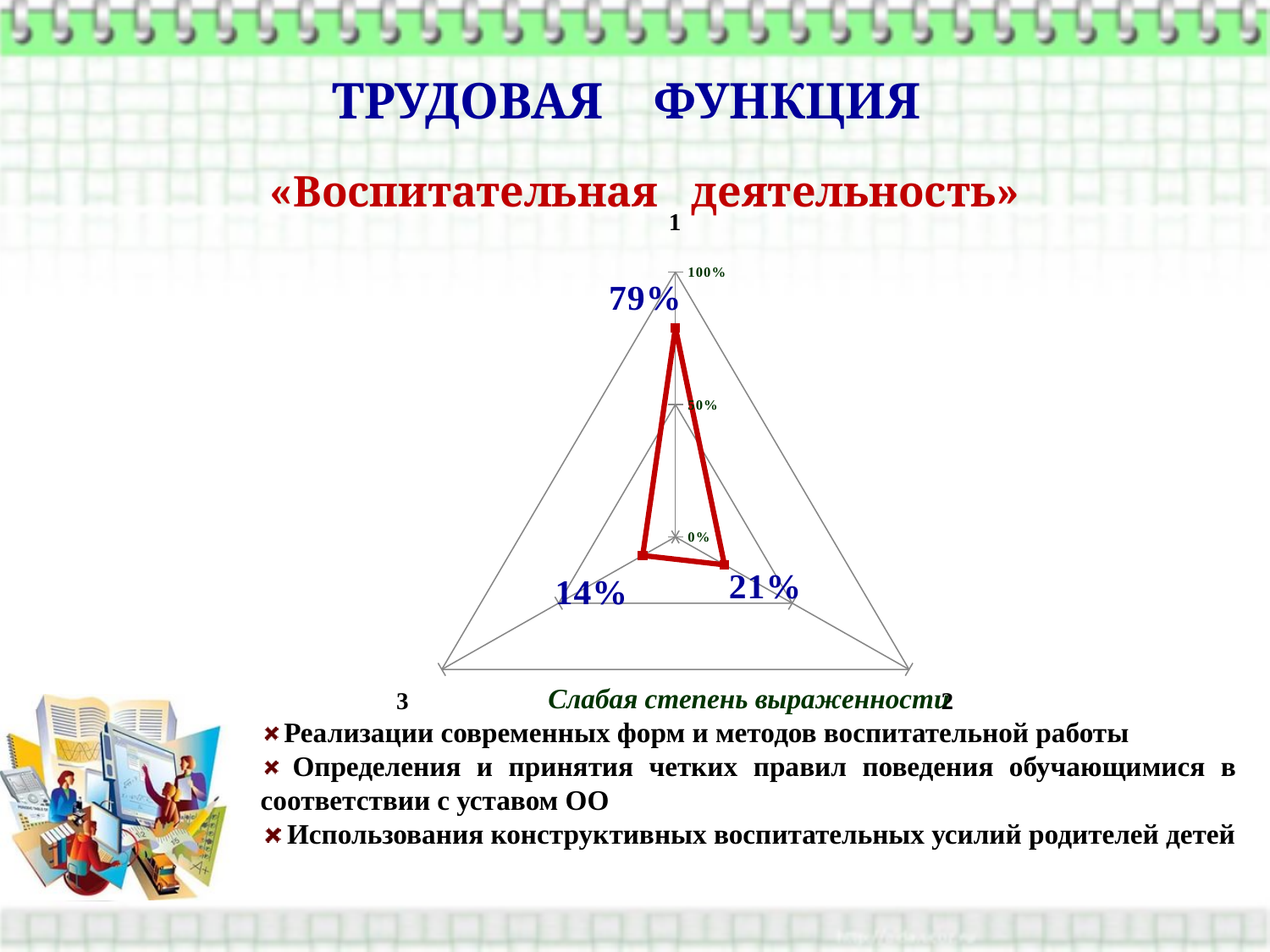
What is the difference between the values for category 2 and category 3? 7% What is the value for category 2 on the radar chart? 21% What is the highest tick value shown on the radar chart's axis? 100% Which category has the highest value on the radar chart? 1 What is the difference between the values for category 1 and category 2? 58% Which is larger, the value for category 2 or the value for category 3? category 2 Which category has the lowest value on the radar chart? 3 What is the value for category 3 on the radar chart? 14% What kind of chart is shown on the slide? radar chart How many categories (axes) does the radar chart have? 3 Is the value for category 1 greater or less than 50%? greater What is the value for category 1 on the radar chart? 79%